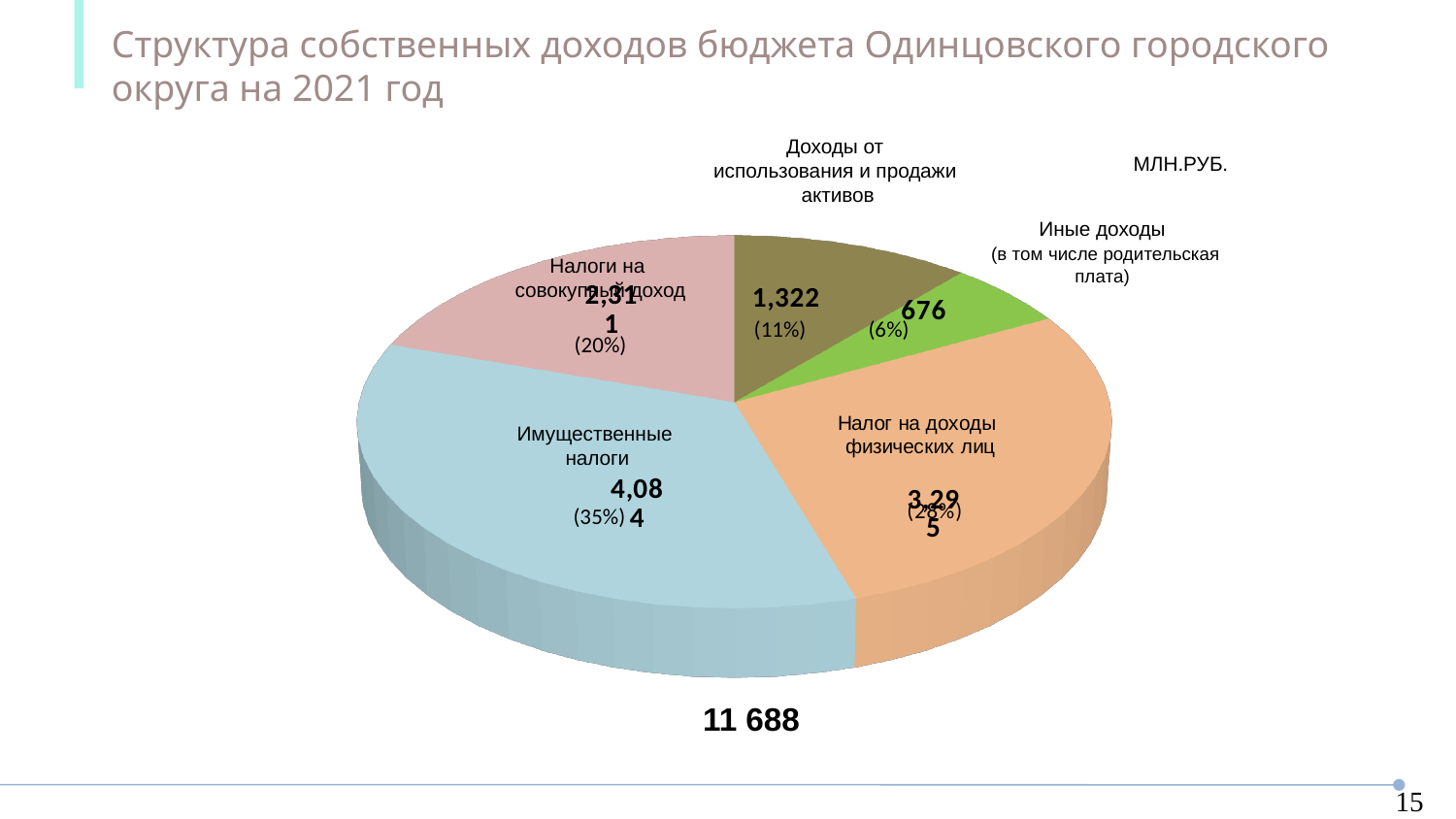
What is the value for «Доходы от использования и продажи активов»? 1,322 How many slices does the pie chart have? 5 Which category has the largest slice of the pie? Имущественные налоги What total figure is printed below the pie chart? 11 688 What kind of chart is shown on the slide? pie chart What share of the pie does «Имущественные налоги» represent? 35% What share of the pie does «Доходы от использования и продажи активов» represent? 11% What is the value for «Иные доходы (в том числе родительская плата)»? 676 What is the difference between the values for «Доходы от использования и продажи активов» and «Иные доходы»? 646 What share of the pie does «Налоги на совокупный доход» represent? 20% Which category has the smallest slice of the pie? Иные доходы (в том числе родительская плата) Which is larger: «Налог на доходы физических лиц» or «Налоги на совокупный доход»? Налог на доходы физических лиц